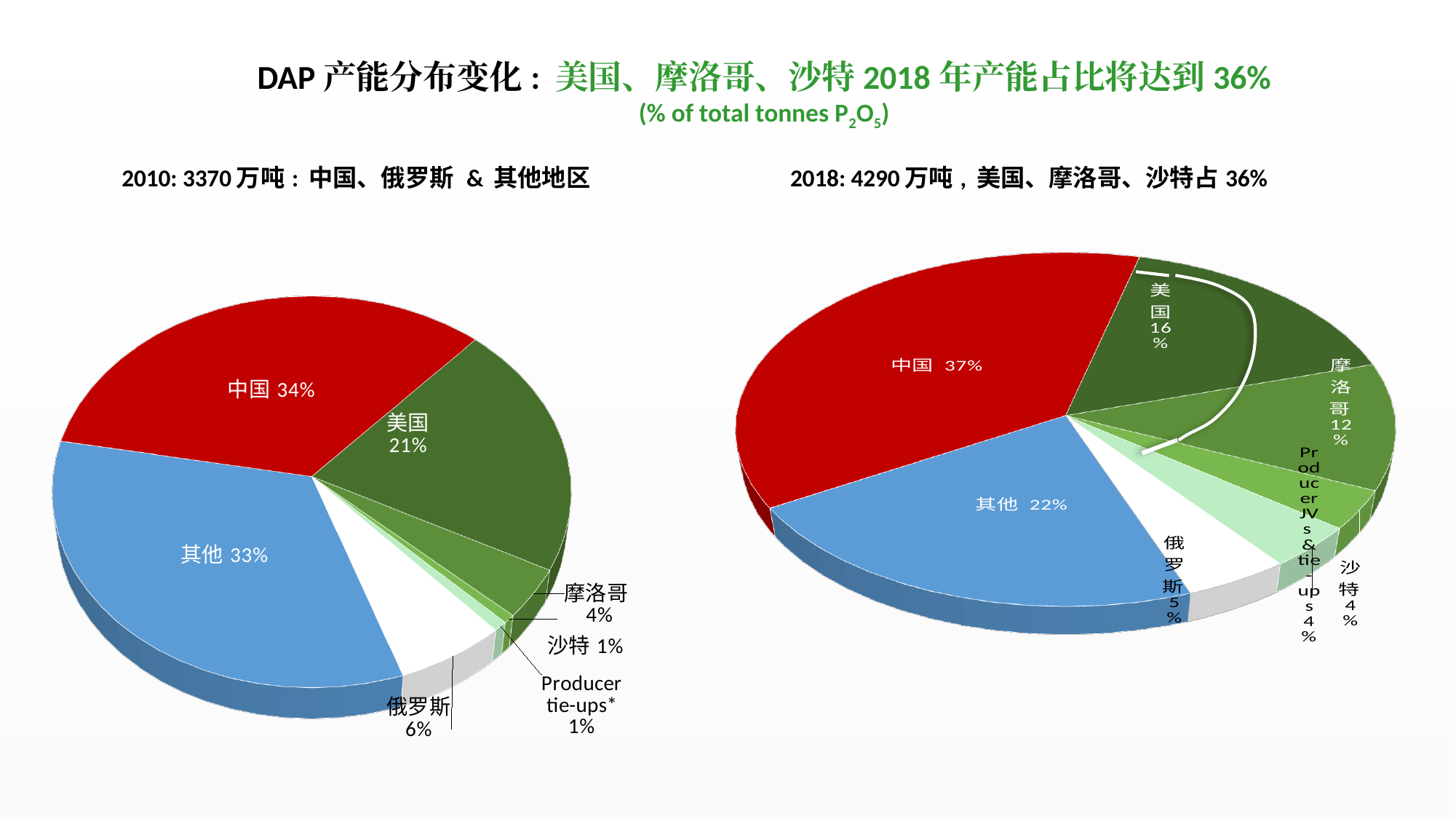
How many slices does the 2018 pie chart have? 7 In the 2010 pie chart, what is the difference between the shares of 美国 and 摩洛哥? 17% In the 2018 pie chart, what share does 美国 hold? 16% In the 2010 pie chart, what share does 俄罗斯 hold? 6% In the 2010 pie chart, which is larger, 其他 or 美国? 其他 In the 2010 pie chart, which category has the largest share? 中国 In the 2018 pie chart, what share does 摩洛哥 hold? 12% In the 2018 pie chart, what is the difference between the shares of 中国 and 其他? 15% According to the subtitle above the 2018 chart, what is the total DAP capacity in 2018? 4290 万吨 What type of chart is used on the left side of the slide for 2010? Pie chart In the 2018 pie chart, which category has the largest share? 中国 In the 2010 pie chart, what share does 中国 hold? 34%